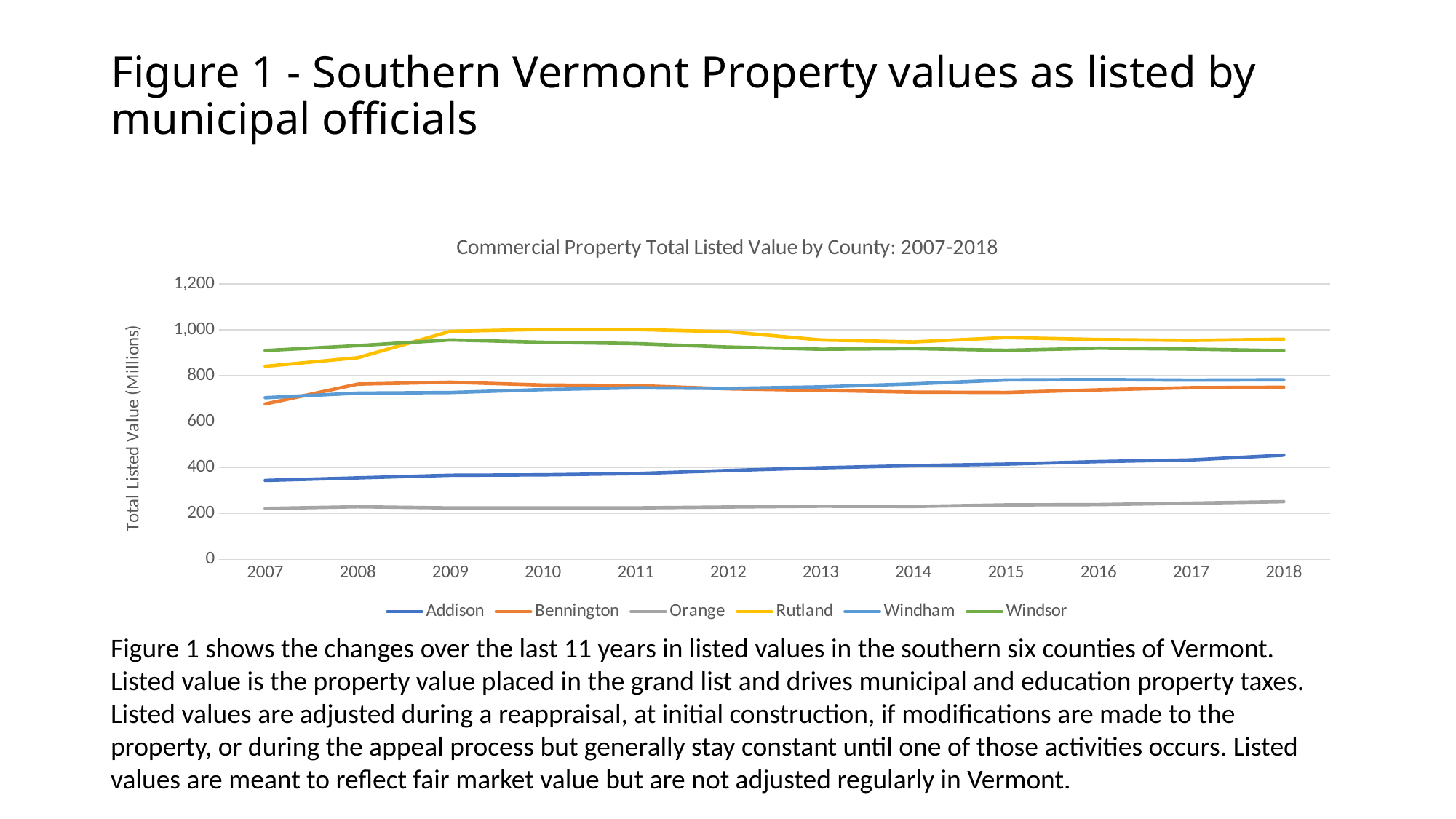
How many years are plotted along the x axis? 12 Which county has the highest listed value in 2018? Rutland Is the value for Addison in 2018 greater or less than 400? greater Does the value for Addison rise or fall from 2007 to 2018? rise What kind of chart is shown on the slide? line chart What is the label on the vertical axis of the chart? Total Listed Value (Millions) In 2007, which is larger: the value for Rutland or the value for Windsor? Windsor What is the title of the chart? Commercial Property Total Listed Value by County: 2007-2018 How many series does the legend list? 6 Which county has the highest listed value in 2007? Windsor Is the value for Orange in 2007 greater or less than 400? less Which county has the lowest listed value in 2018? Orange